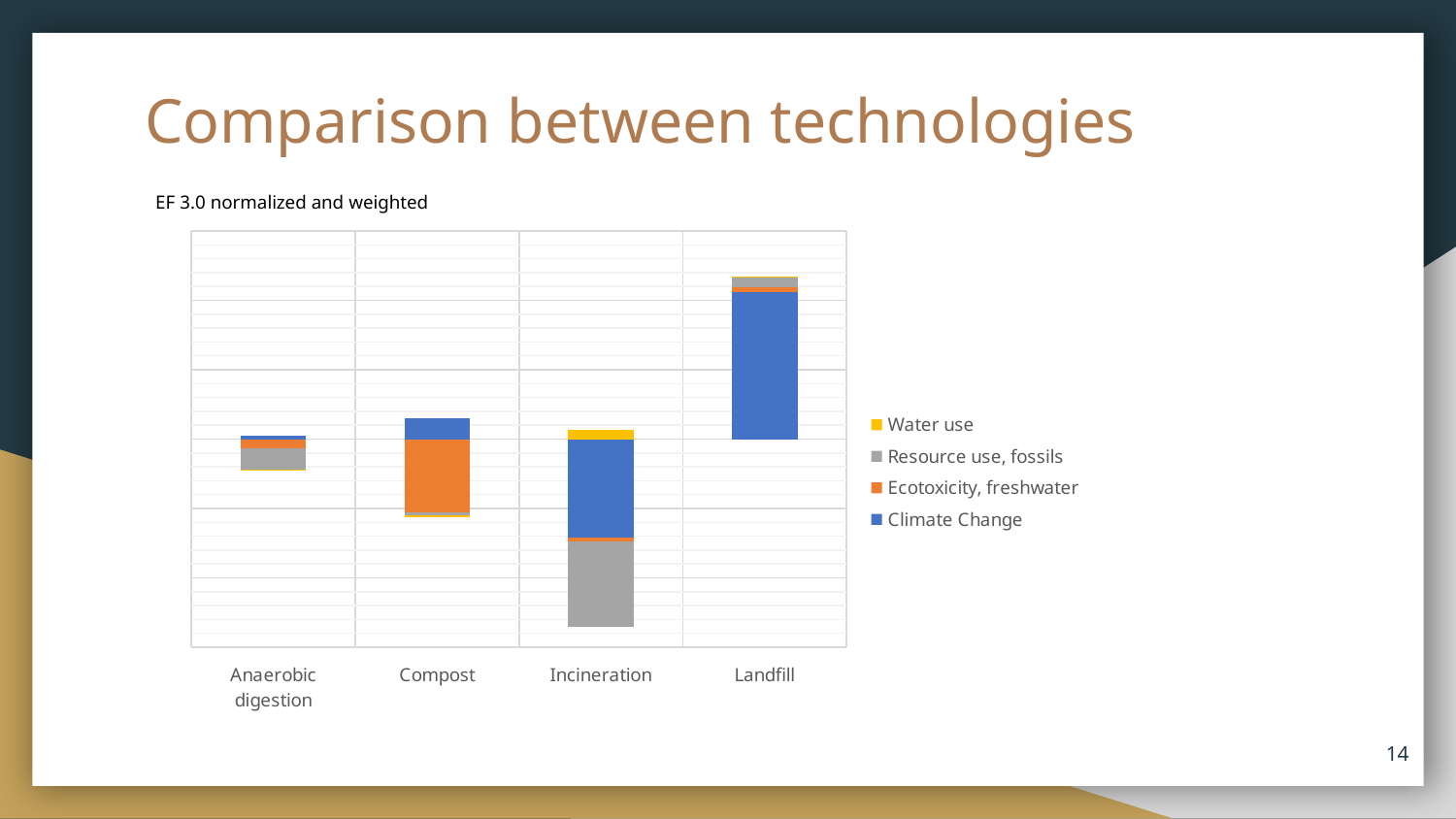
Which technology has the highest Climate Change value in the chart? Landfill How many series does the chart's legend list? 4 How many technology categories are shown on the x axis of the chart? 4 Is the Ecotoxicity, freshwater segment larger for Compost or for Anaerobic digestion? Compost What kind of chart is shown on the slide? Stacked bar chart Which series are listed in the chart's legend? Water use; Resource use, fossils; Ecotoxicity, freshwater; Climate Change Which technology has the largest negative Resource use, fossils segment in the chart? Incineration Which technology has the largest Ecotoxicity, freshwater segment in the chart? Compost What is the title of the chart? EF 3.0 normalized and weighted Which technology has the smallest Climate Change segment in the chart? Anaerobic digestion Is the Climate Change segment larger for Landfill or for Compost? Landfill